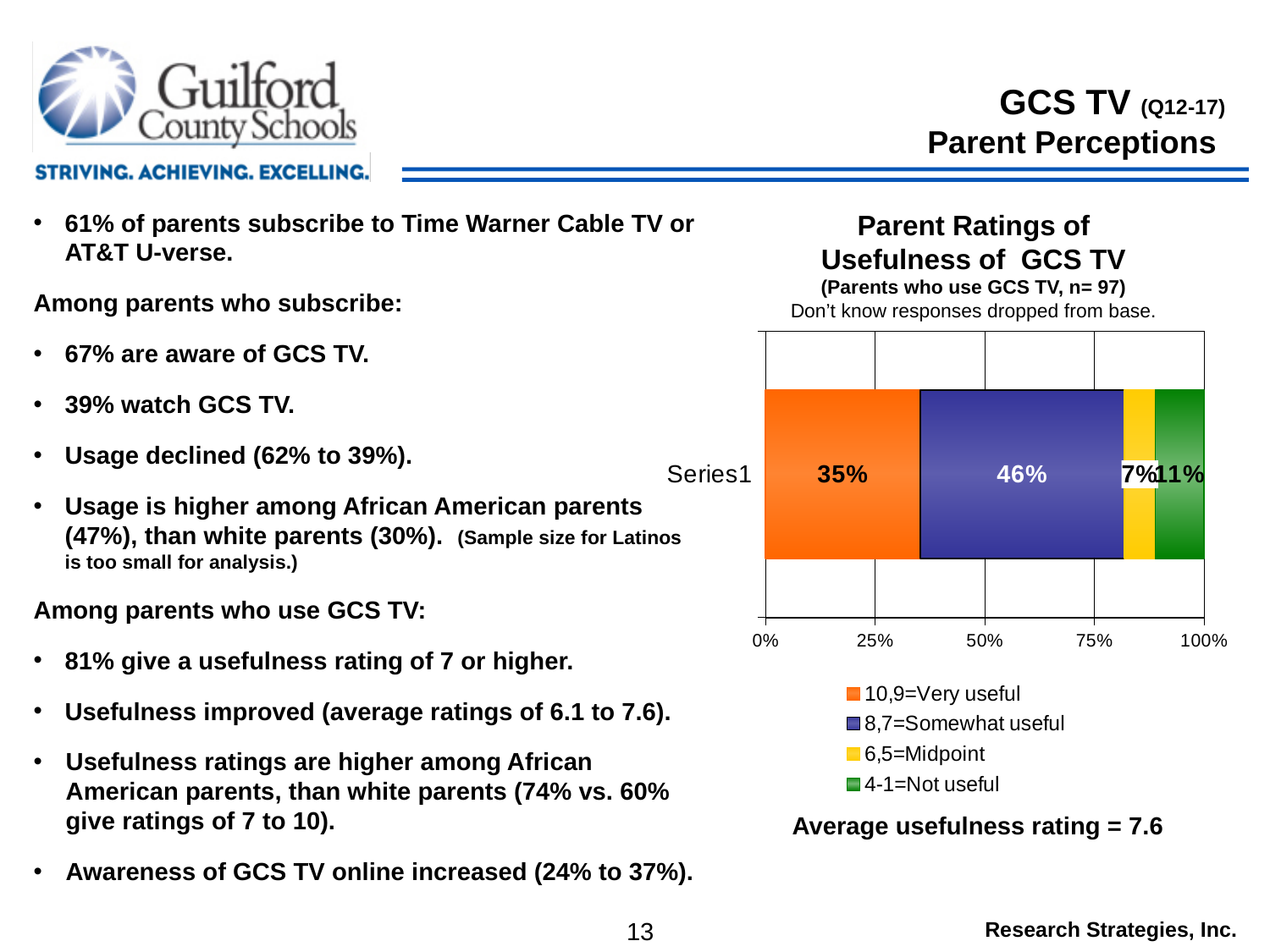
What kind of chart is shown on the slide? stacked bar chart What is the value for the "6,5=Midpoint" segment? 7% What is the value for the "10,9=Very useful" segment? 35% Which rating category has the largest share of the bar? 8,7=Somewhat useful How many series does the legend list? 4 What is the title of the chart? Parent Ratings of Usefulness of GCS TV What is the total of the stacked bar's labelled segments? 99% What is the difference between the "Somewhat useful" and "Very useful" values? 11% What is the value for the "8,7=Somewhat useful" segment? 46% Which is larger, the "Not useful" value or the "Midpoint" value? Not useful Which rating category has the smallest share of the bar? 6,5=Midpoint What is the value for the "4-1=Not useful" segment? 11%